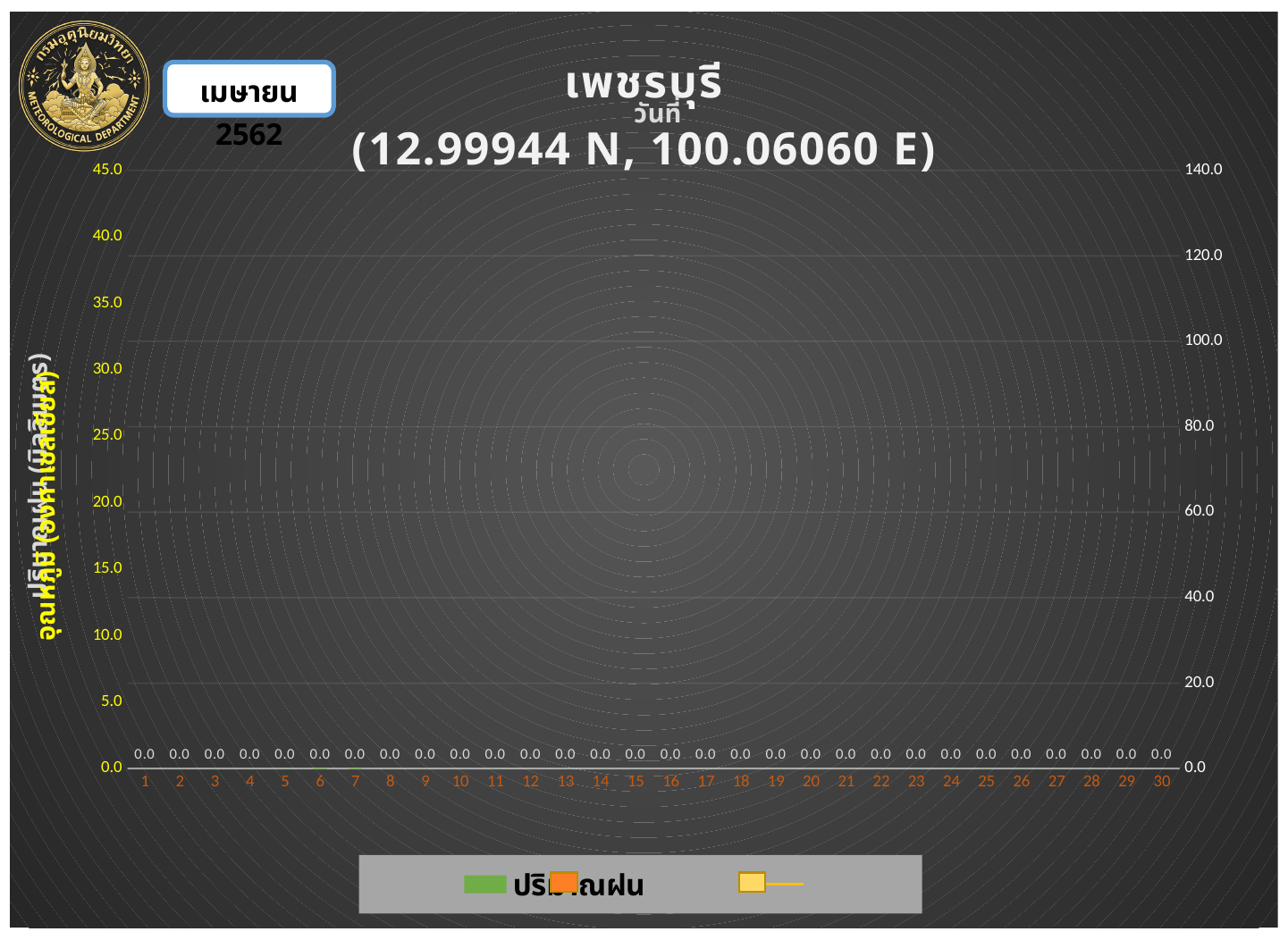
What is the highest tick value on the right vertical axis of the chart? 140.0 What are the coordinates shown in the chart title? 12.99944 N, 100.06060 E What is the data label shown for day 30 on the chart? 0.0 What is the data label shown for day 15 on the chart? 0.0 How many day categories are shown along the x axis of the chart? 30 What is the data label shown for day 1 on the chart? 0.0 What is the highest tick value on the left vertical axis of the chart? 45.0 What is the difference between the data labels for day 6 and day 20? 0.0 Is the data label for day 10 greater or less than 5.0? less Do the data labels rise, fall, or stay the same from day 1 to day 30? stay the same